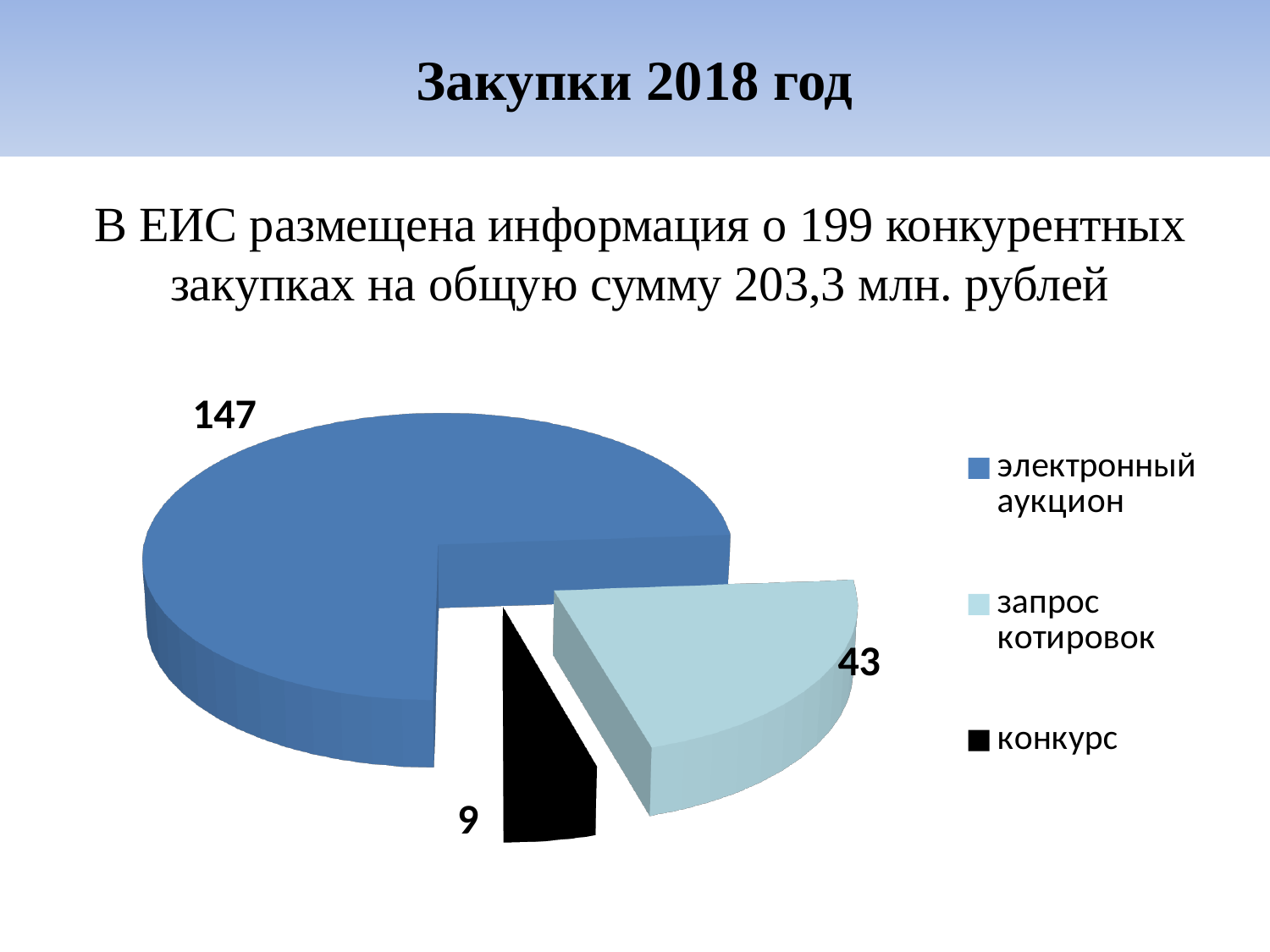
How many slices does the pie chart have? 3 What is the total of all slices in the pie chart? 199 Which is larger, the value for запрос котировок or the value for конкурс? запрос котировок What is the difference between the values for электронный аукцион and запрос котировок? 104 Which category has the largest slice of the pie? электронный аукцион Which category has the smallest slice of the pie? конкурс What is the value for конкурс? 9 What is the value for запрос котировок? 43 What type of chart is shown on the slide? pie chart What is the difference between the values for запрос котировок and конкурс? 34 What is the value for электронный аукцион? 147 What colour is the slice for конкурс? black